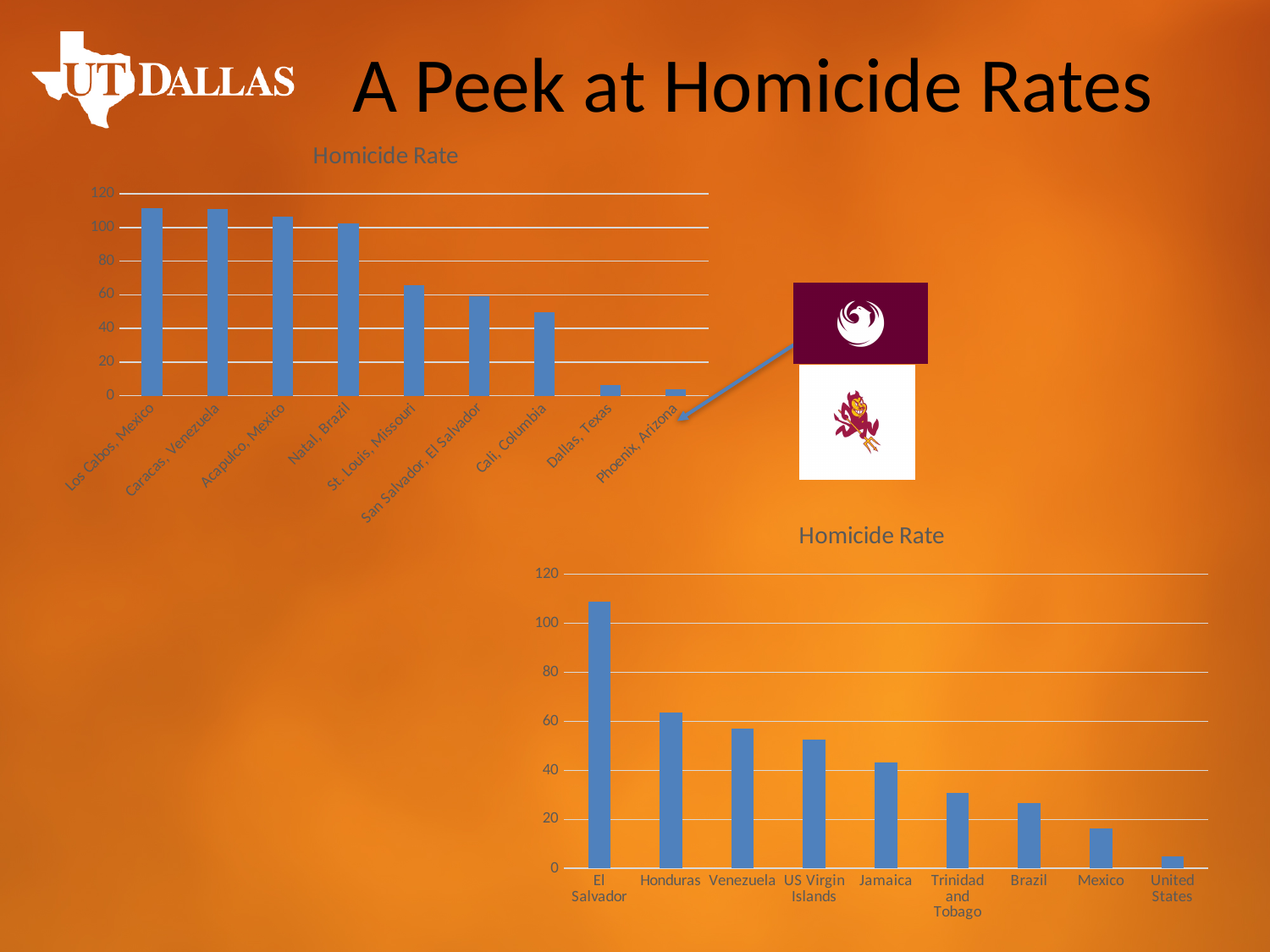
In the bottom chart (countries), which category has the highest homicide rate? El Salvador How many categories are shown in the top chart (cities)? 9 In the bottom chart (countries), is the value for El Salvador greater or less than 100? greater In the bottom chart (countries), is the value for Mexico greater or less than 20? less What kind of chart is the top chart (cities)? Bar chart In the top chart (cities), is the value for St. Louis, Missouri greater or less than 60? greater In the bottom chart (countries), which is larger, the value for Jamaica or the value for Brazil? Jamaica How many categories are shown in the bottom chart (countries)? 9 In the top chart (cities), which is larger, the value for Natal, Brazil or the value for Cali, Columbia? Natal, Brazil In the bottom chart (countries), which category has the lowest homicide rate? United States